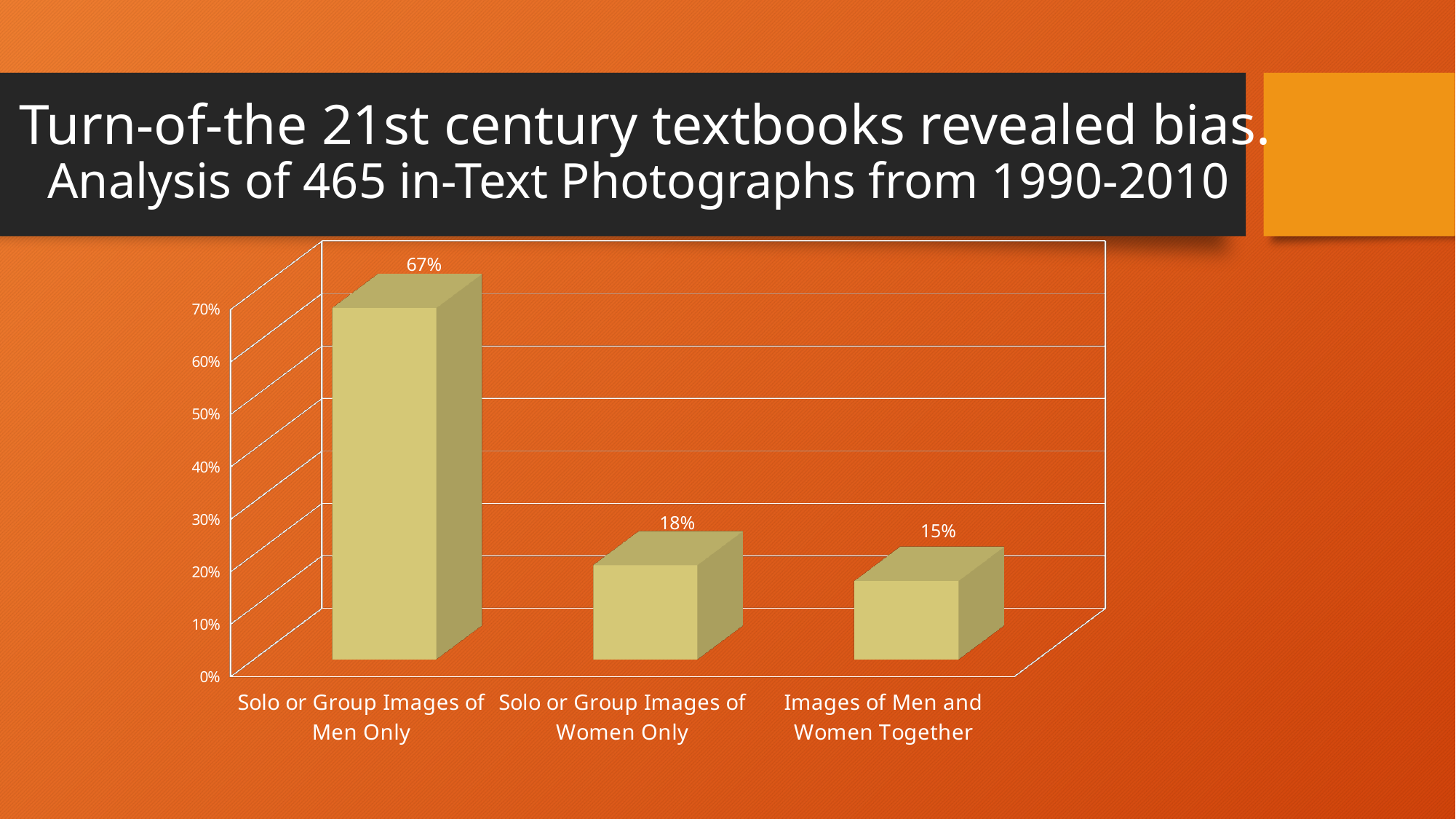
Which is larger: the value for Solo or Group Images of Women Only or the value for Images of Men and Women Together? Solo or Group Images of Women Only Which category has the highest percentage? Solo or Group Images of Men Only What percentage is shown for Solo or Group Images of Men Only? 67% Is the value for Solo or Group Images of Men Only greater or less than 60%? greater What kind of chart is shown on the slide? Bar chart What percentage is shown for Images of Men and Women Together? 15% What is the difference in percentage points between Solo or Group Images of Women Only and Images of Men and Women Together? 3 Do the values rise or fall from left to right across the categories? Fall What percentage is shown for Solo or Group Images of Women Only? 18% Which category has the lowest percentage? Images of Men and Women Together What is the difference in percentage points between Solo or Group Images of Men Only and Solo or Group Images of Women Only? 49 How many categories are shown in the chart? 3